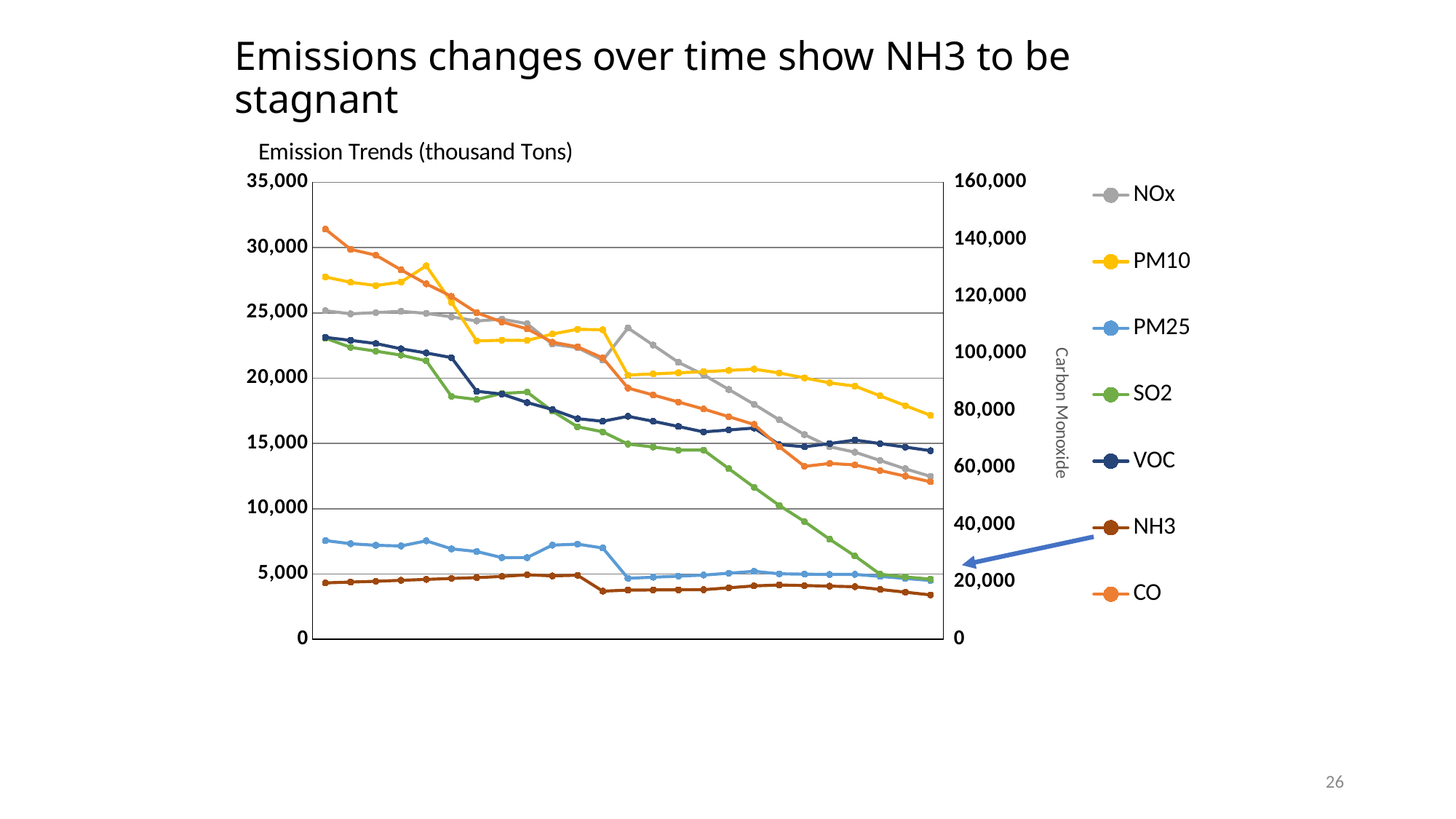
What is the label of the secondary (right-hand) vertical axis? Carbon Monoxide At the start of the period, which is higher on the left axis: PM10 or NOx? PM10 How many series does the legend list? 7 Is the first value of VOC greater or less than 20,000? greater What kind of chart is shown on the slide? line chart Is the first value of PM25 greater or less than 10,000? less Does the SO2 series rise or fall over the period shown? fall At the end of the period, which is higher: PM10 or VOC? PM10 Is the first value of PM10 greater or less than 25,000? greater Which series stays lowest on the chart across the whole period? NH3 What is the title of the chart? Emission Trends (thousand Tons)